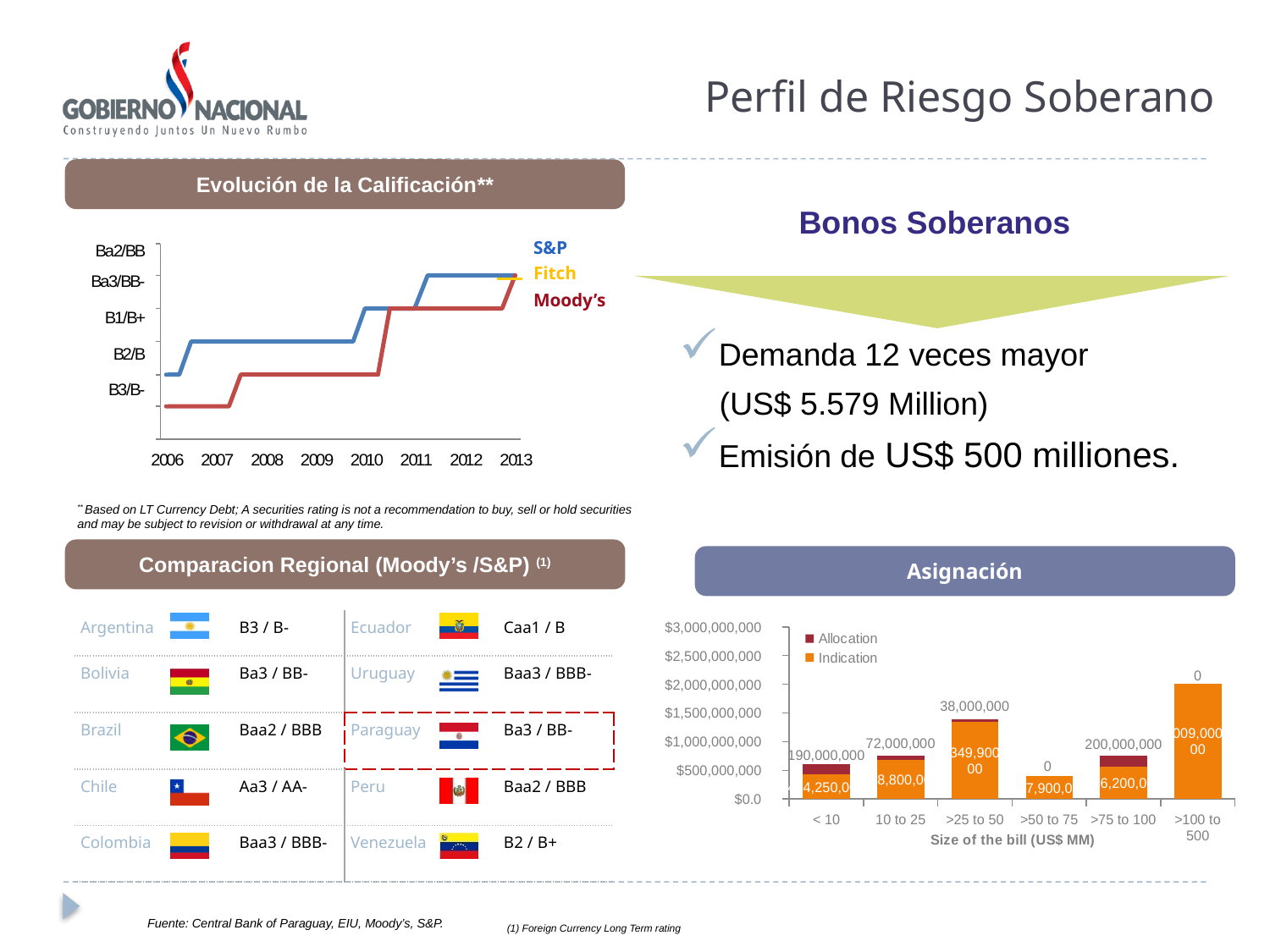
In the 'Evolución de la Calificación**' chart, how many series does the legend list? 3 In the 'Evolución de la Calificación**' chart, what kind of chart is it? line chart In the 'Evolución de la Calificación**' chart, what rating does the S&P line reach in 2013? Ba3/BB- In the 'Evolución de la Calificación**' chart, how many years are shown on the x axis? 8 In the 'Asignación' chart, how many series does the legend list? 2 In the 'Asignación' chart, what is the Allocation value for the '>75 to 100' category? 200,000,000 In the 'Asignación' chart, how many bill-size categories are shown on the x axis? 6 In the 'Asignación' chart, what is the difference between the Allocation values for '< 10' and '10 to 25'? 118,000,000 In the 'Asignación' chart, what kind of chart is it? bar chart In the 'Evolución de la Calificación**' chart, do the ratings rise or fall from 2006 to 2013? rise In the 'Asignación' chart, which category has the highest Allocation value? >75 to 100